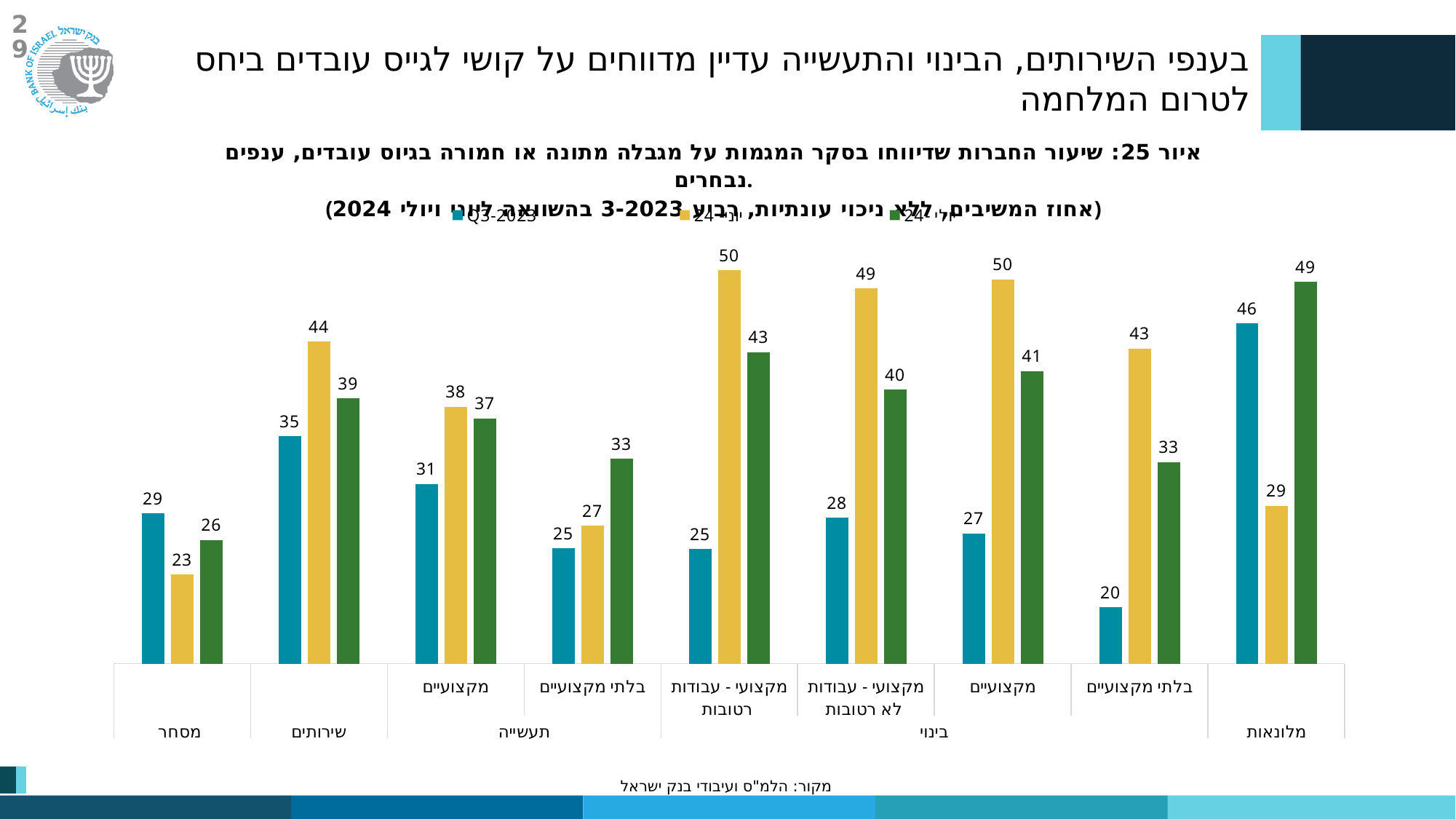
What is the value of the green bar for מלונאות (hotels)? 49 What kind of chart is shown on the slide? Bar chart Which category has the lowest Q3-2023 (teal) bar? בינוי – בלתי מקצועיים (construction – non-professional) What is the Q3-2023 (teal) value for מסחר (trade)? 29 How many series does the legend list? 3 How many category groups of bars are shown on the chart? 9 For שירותים (services), how much higher is the yellow bar than the Q3-2023 (teal) bar? 9 For מסחר (trade), which is larger: the Q3-2023 (teal) bar or the yellow bar? Q3-2023 (teal) What is the value of the yellow bar for שירותים (services)? 44 What is the value of the yellow bar for בינוי – מקצועי, עבודות רטובות (construction – professional, wet works)? 50 Which category has the highest Q3-2023 (teal) bar? מלונאות (hotels) For מלונאות (hotels), what is the difference between the green bar and the yellow bar? 20